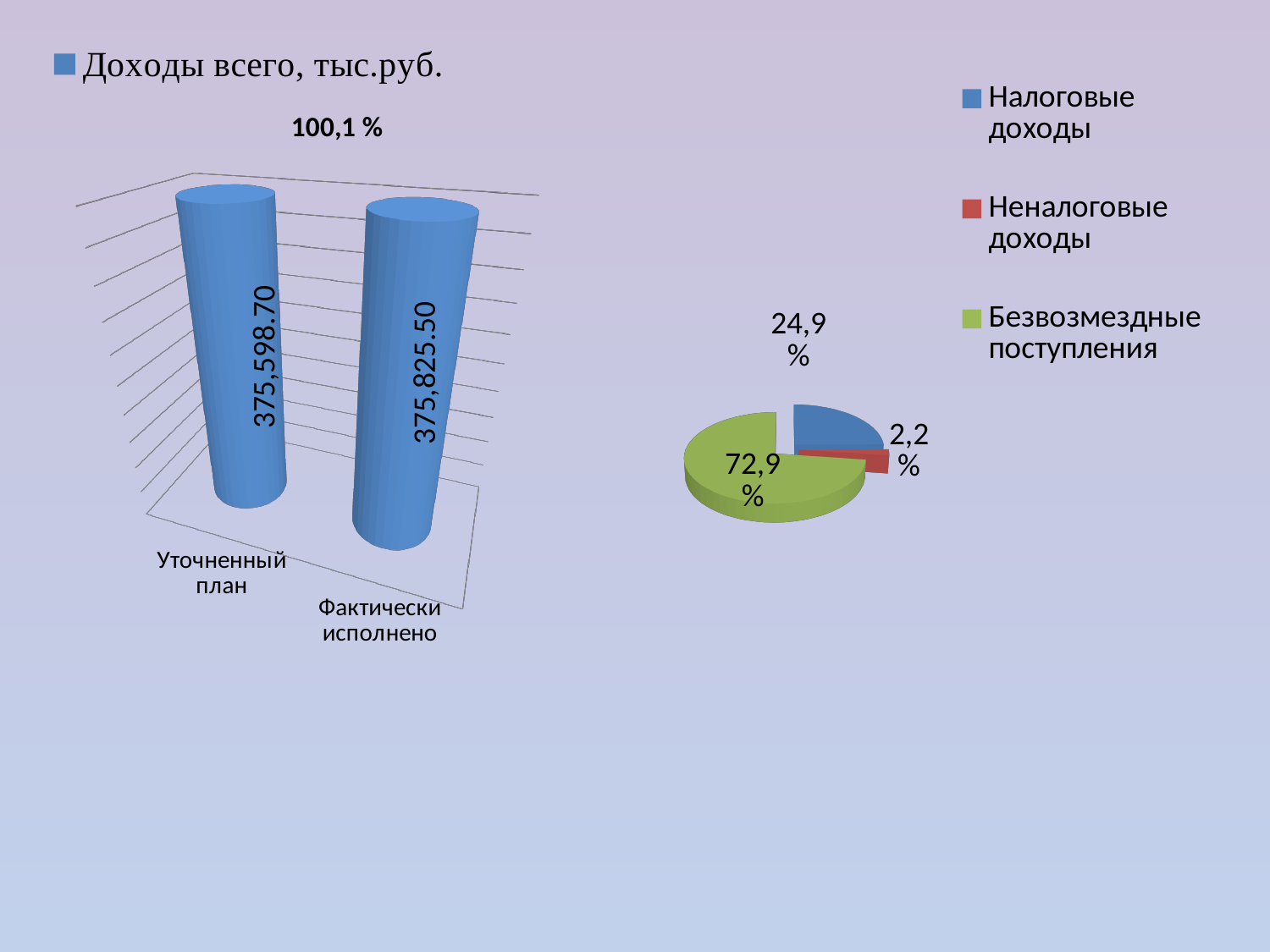
In the bar chart on the left, what is the value for Фактически исполнено? 375,825.50 In the bar chart on the left, what is the difference between Фактически исполнено and Уточненный план? 226.80 In the bar chart on the left, which category has the higher value, Уточненный план or Фактически исполнено? Фактически исполнено How many categories does the legend of the pie chart on the right list? 3 In the bar chart on the left, what is the value for Уточненный план? 375,598.70 What is the legend entry of the bar chart on the left? Доходы всего, тыс.руб. In the pie chart on the right, what share does Налоговые доходы have? 24,9 % In the pie chart on the right, what share does Неналоговые доходы have? 2,2 % How many bars are in the bar chart on the left? 2 In the pie chart on the right, which category has the largest share? Безвозмездные поступления In the pie chart on the right, which category has the smallest share? Неналоговые доходы What type of chart is the chart on the left? bar chart